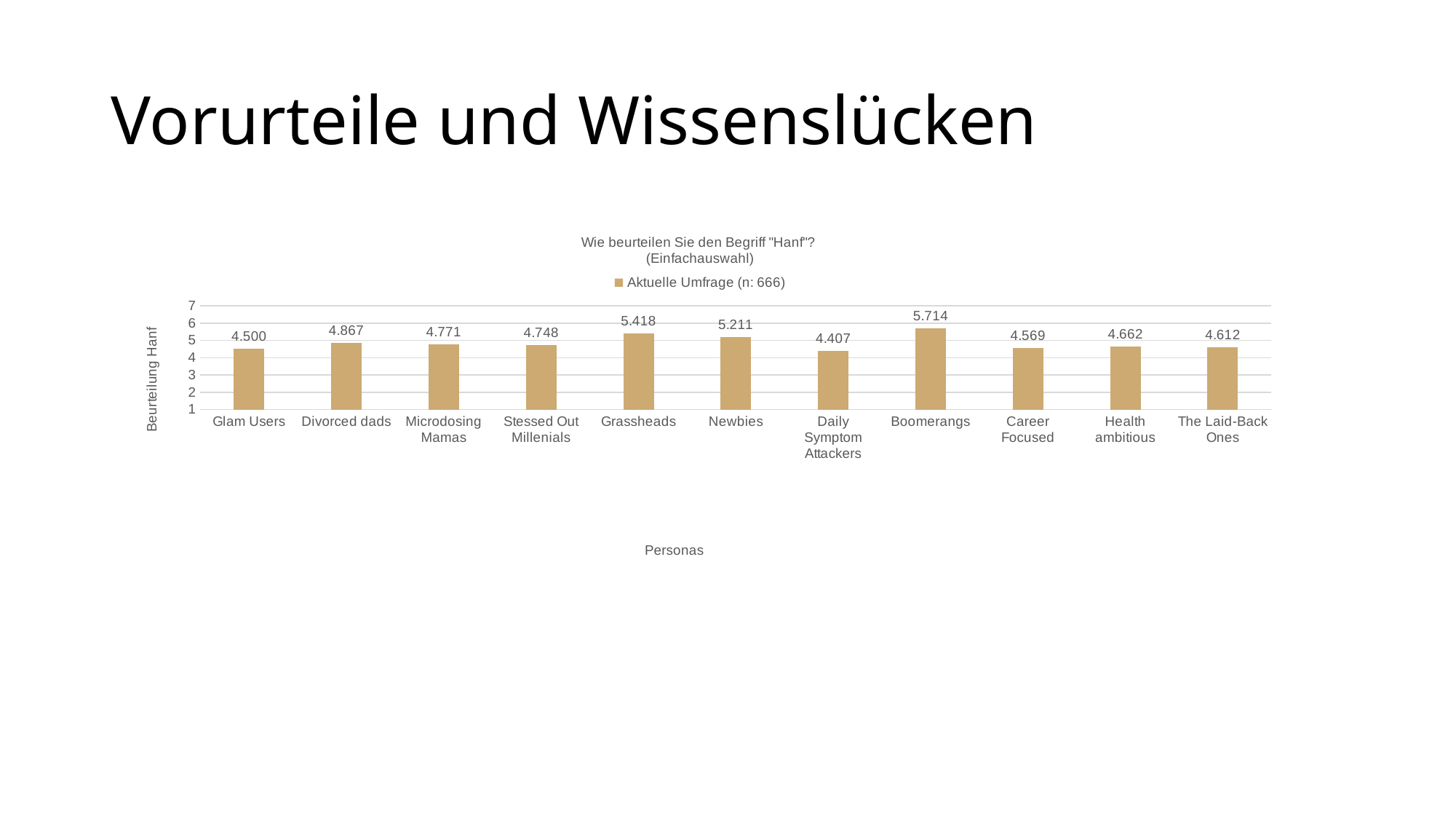
How many series does the legend list? 1 What is the value for Microdosing Mamas? 4.771 What is the difference between the values for Boomerangs and Daily Symptom Attackers? 1.307 What is the value for Boomerangs? 5.714 What is the difference between the values for Grassheads and Newbies? 0.207 What kind of chart is shown? bar chart Which persona has the lowest value? Daily Symptom Attackers Is the value for Grassheads greater or less than 5? greater What is the value for Daily Symptom Attackers? 4.407 Which has a larger value, Divorced dads or Glam Users? Divorced dads Which persona has the highest value? Boomerangs How many personas are shown on the x axis? 11